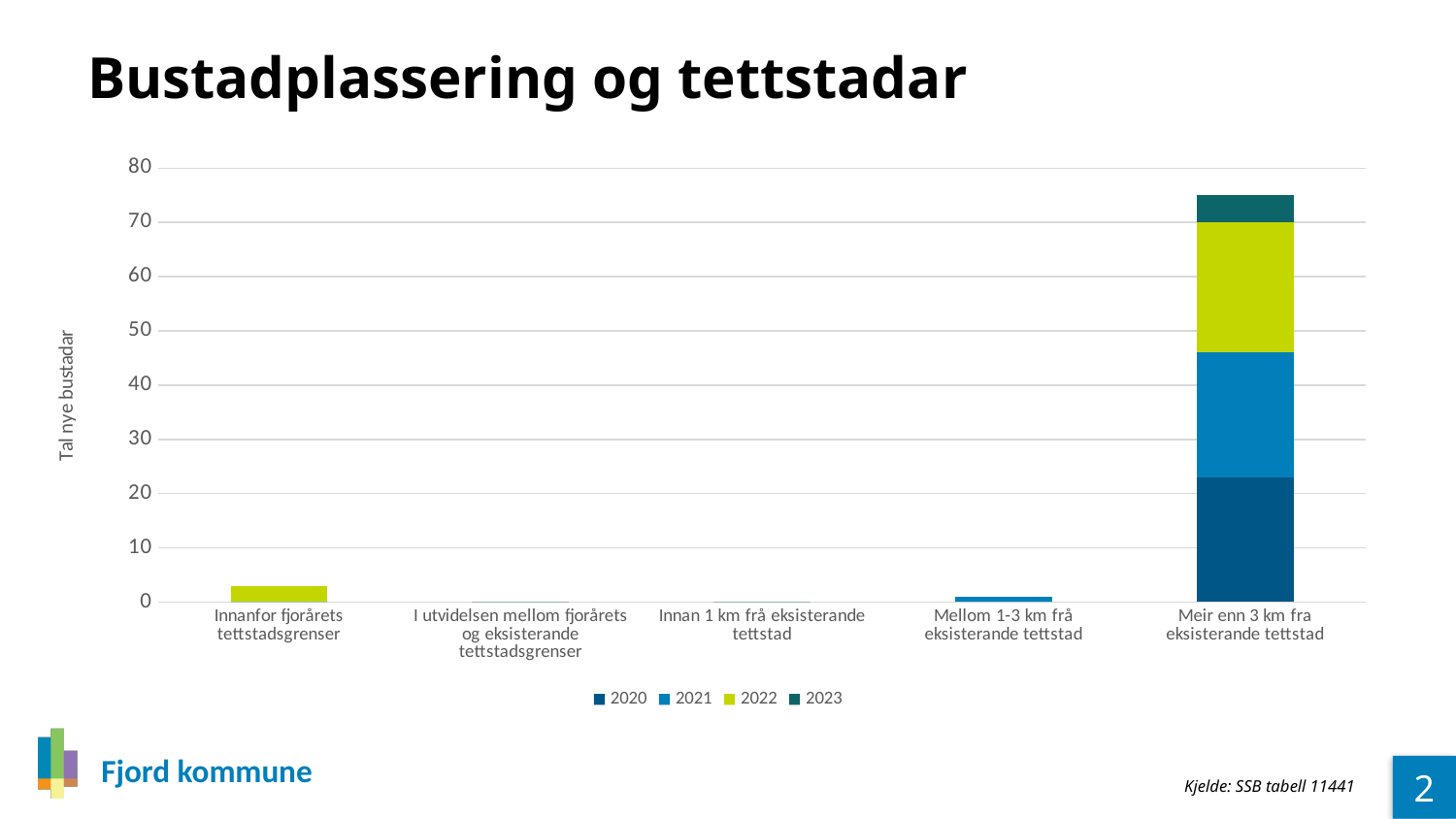
Which year in the legend is shown in yellow-green? 2022 Is the total value for 'Innanfor fjorårets tettstadsgrenser' greater or less than 10? less Is the total value for 'Meir enn 3 km fra eksisterande tettstad' greater or less than 70? greater How many categories are shown on the x axis of the chart? 5 Is the total value for 'Mellom 1-3 km frå eksisterande tettstad' greater or less than 10? less How many series does the chart legend list? 4 What kind of chart is shown on the slide? Stacked bar chart Which has a larger total: 'Meir enn 3 km fra eksisterande tettstad' or 'Innanfor fjorårets tettstadsgrenser'? Meir enn 3 km fra eksisterande tettstad What is the label on the vertical axis of the chart? Tal nye bustadar Which category has the highest total number of new dwellings? Meir enn 3 km fra eksisterande tettstad